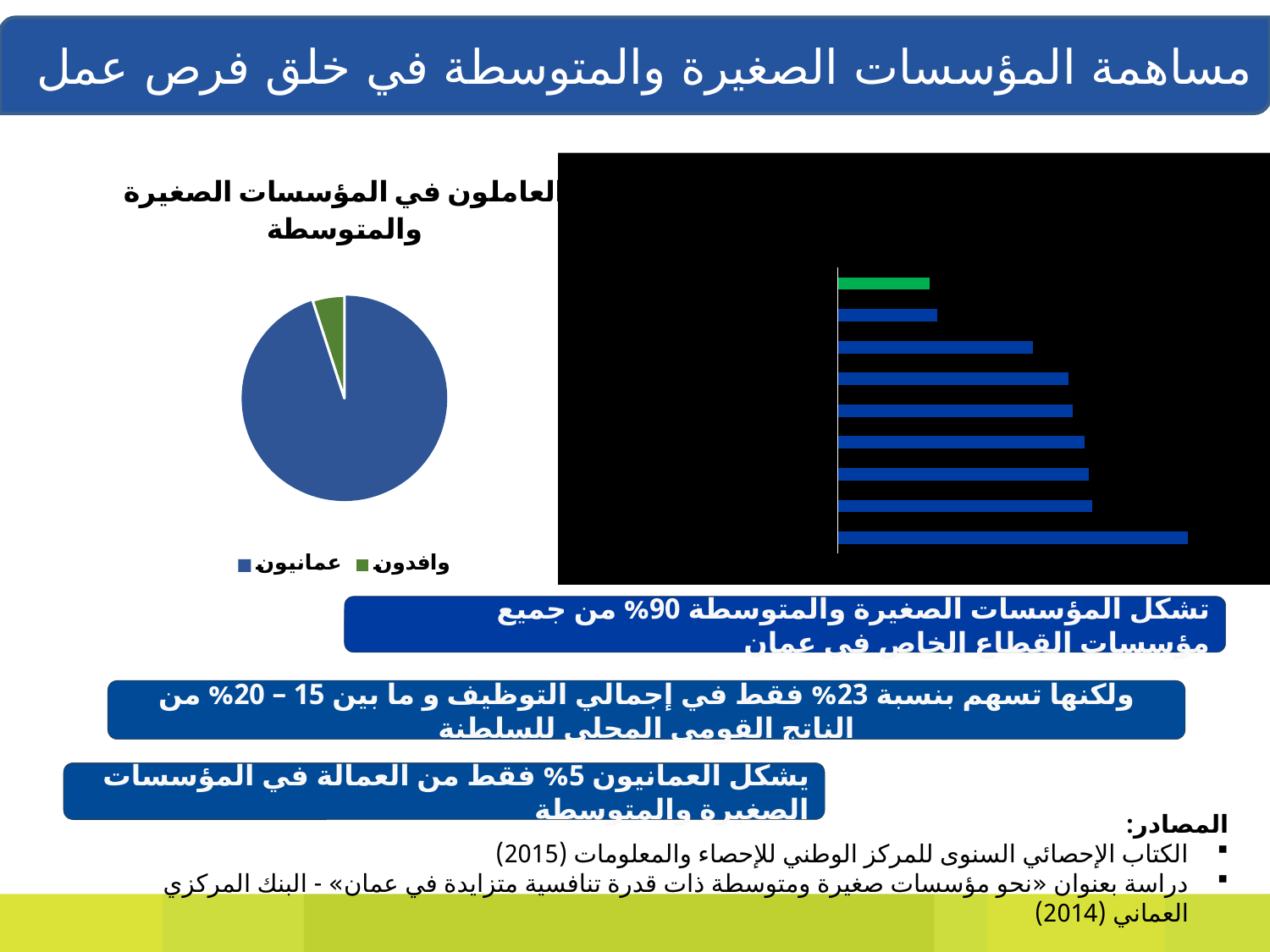
In the pie chart on the left, which category has the largest slice? وافدون In the chart on the right with the black background, which bar is the longest, the top one or the bottom one? the bottom one In the pie chart on the left, what colour is the slice for 'عمانيون'? green In the pie chart on the left, how many entries does the legend list? 2 How many bars are plotted in the chart on the right with the black background? 9 What kind of chart is the chart on the right with the black background? bar chart What kind of chart is the chart on the left titled 'العاملون في المؤسسات الصغيرة والمتوسطة'? pie chart In the pie chart on the left, which category has the smallest slice? عمانيون In the pie chart on the left, which slice is larger, 'وافدون' or 'عمانيون'? وافدون In the chart on the right with the black background, do the bars get longer or shorter going from top to bottom? longer In the pie chart on the left, what colour is the slice for 'وافدون'? blue